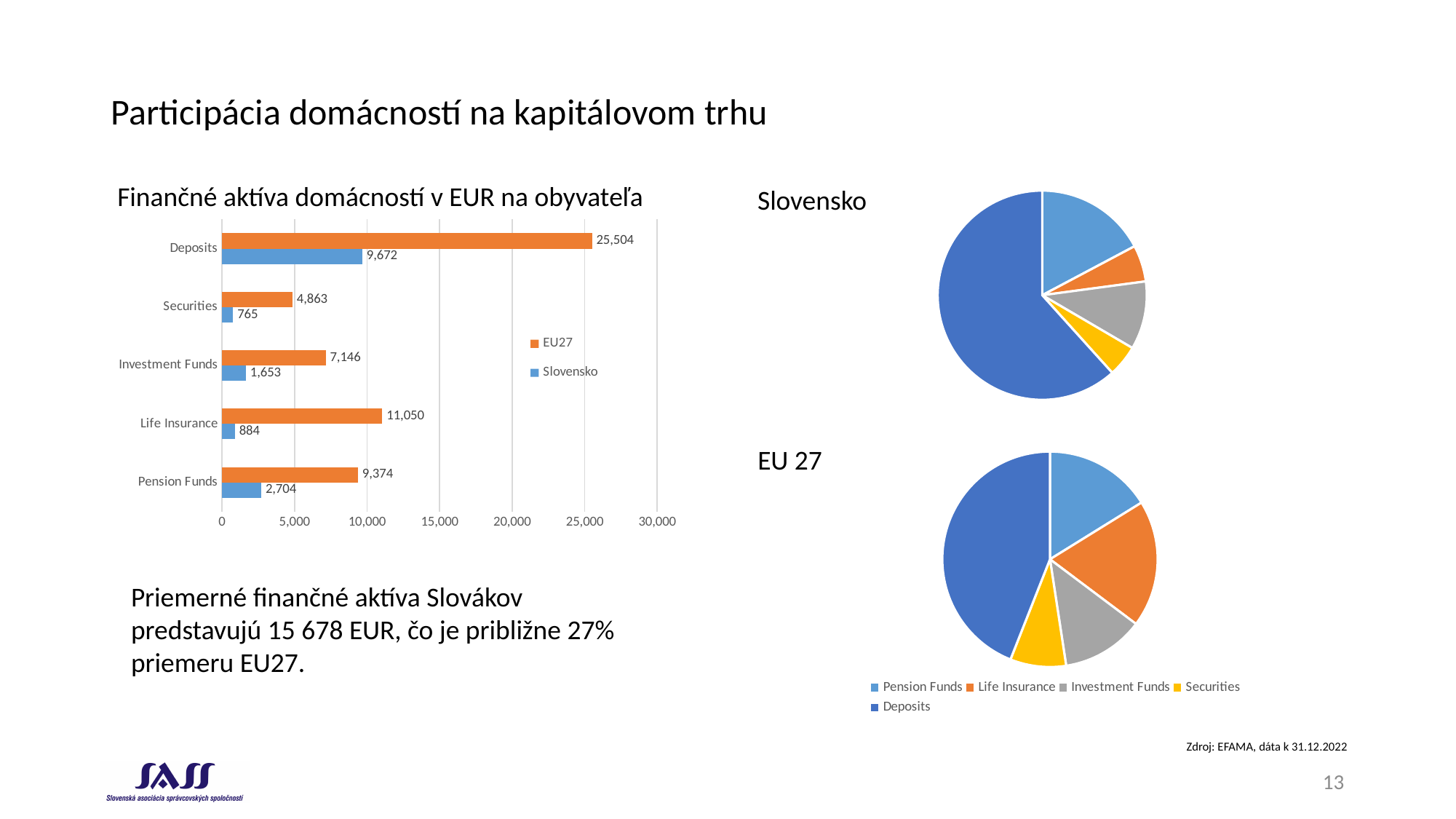
In the bar chart 'Finančné aktíva domácností v EUR na obyvateľa', what is the Slovensko value for Pension Funds? 2,704 In the bar chart 'Finančné aktíva domácností v EUR na obyvateľa', which category has the highest EU27 value? Deposits In the bar chart 'Finančné aktíva domácností v EUR na obyvateľa', which is larger: the EU27 value for Investment Funds or the EU27 value for Pension Funds? Pension Funds In the bar chart 'Finančné aktíva domácností v EUR na obyvateľa', what is the difference between the EU27 and Slovensko values for Deposits? 15,832 In the 'EU 27' pie chart, which category has the smallest slice? Securities In the bar chart 'Finančné aktíva domácností v EUR na obyvateľa', what is the Slovensko value for Life Insurance? 884 What kind of chart is the 'Slovensko' chart on the right of the slide? Pie chart In the 'Slovensko' pie chart, which category has the largest slice? Deposits In the bar chart 'Finančné aktíva domácností v EUR na obyvateľa', what is the EU27 value for Deposits? 25,504 In the bar chart 'Finančné aktíva domácností v EUR na obyvateľa', which category has the lowest Slovensko value? Securities In the bar chart 'Finančné aktíva domácností v EUR na obyvateľa', how many series does the legend list? 2 In the bar chart 'Finančné aktíva domácností v EUR na obyvateľa', how many categories are shown? 5